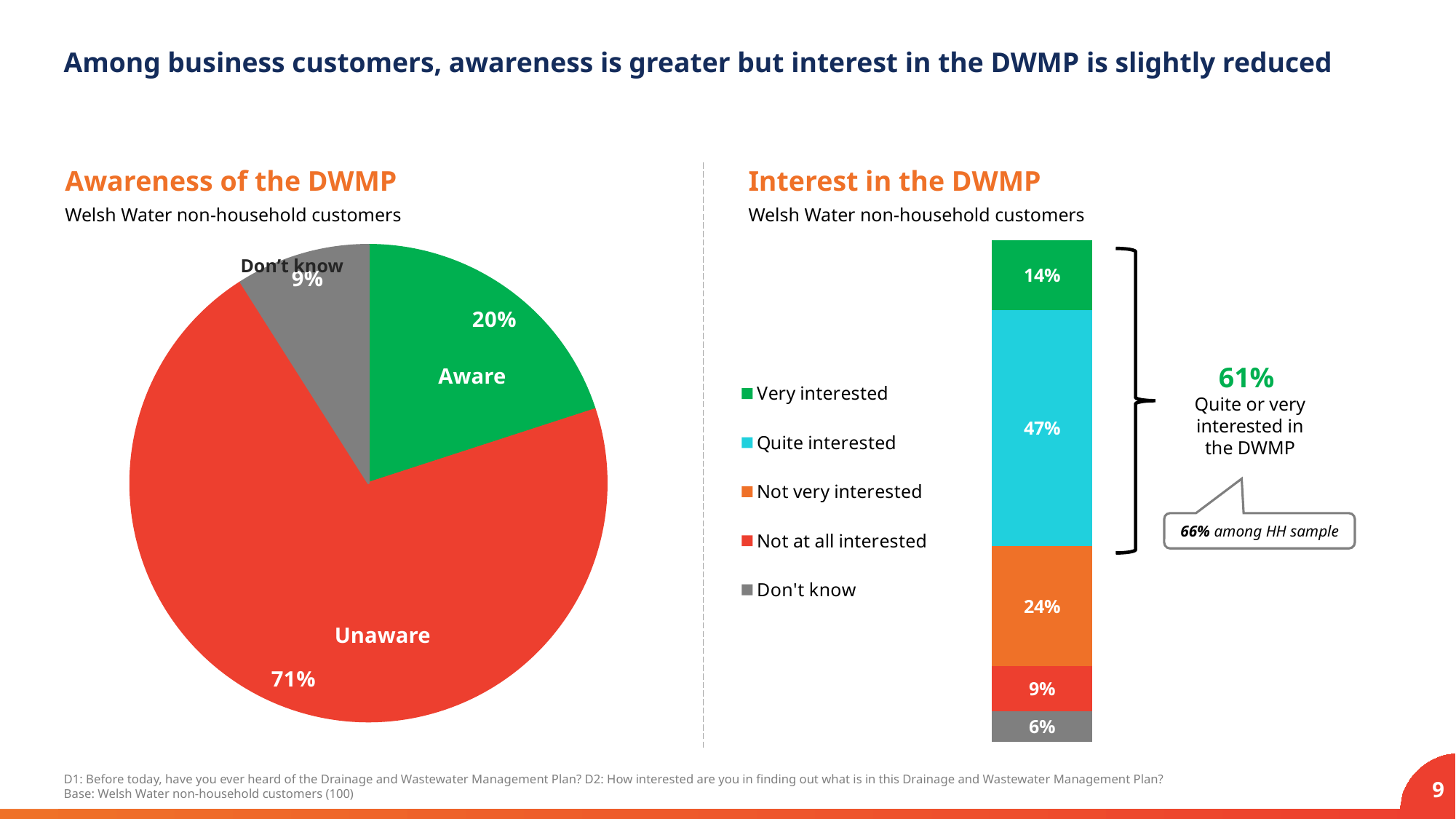
In the 'Interest in the DWMP' chart, what percentage of customers are Not very interested? 24% In the 'Awareness of the DWMP' pie chart, what percentage of customers are Unaware? 71% In the 'Awareness of the DWMP' pie chart, how many slices are there? 3 In the 'Awareness of the DWMP' pie chart, what percentage of customers are Aware? 20% In the 'Interest in the DWMP' chart, which category has the largest segment? Quite interested In the 'Awareness of the DWMP' pie chart, what is the difference between the Unaware and Aware percentages? 51% In the 'Awareness of the DWMP' pie chart, which category has the smallest slice? Don't know What kind of chart is the 'Awareness of the DWMP' chart? Pie chart In the 'Interest in the DWMP' chart, what percentage of customers are Quite interested? 47% In the 'Interest in the DWMP' chart, what is the combined percentage of Very interested and Quite interested? 61% In the 'Interest in the DWMP' chart, which is larger: Very interested or Not at all interested? Very interested In the 'Interest in the DWMP' chart, how many series does the legend list? 5